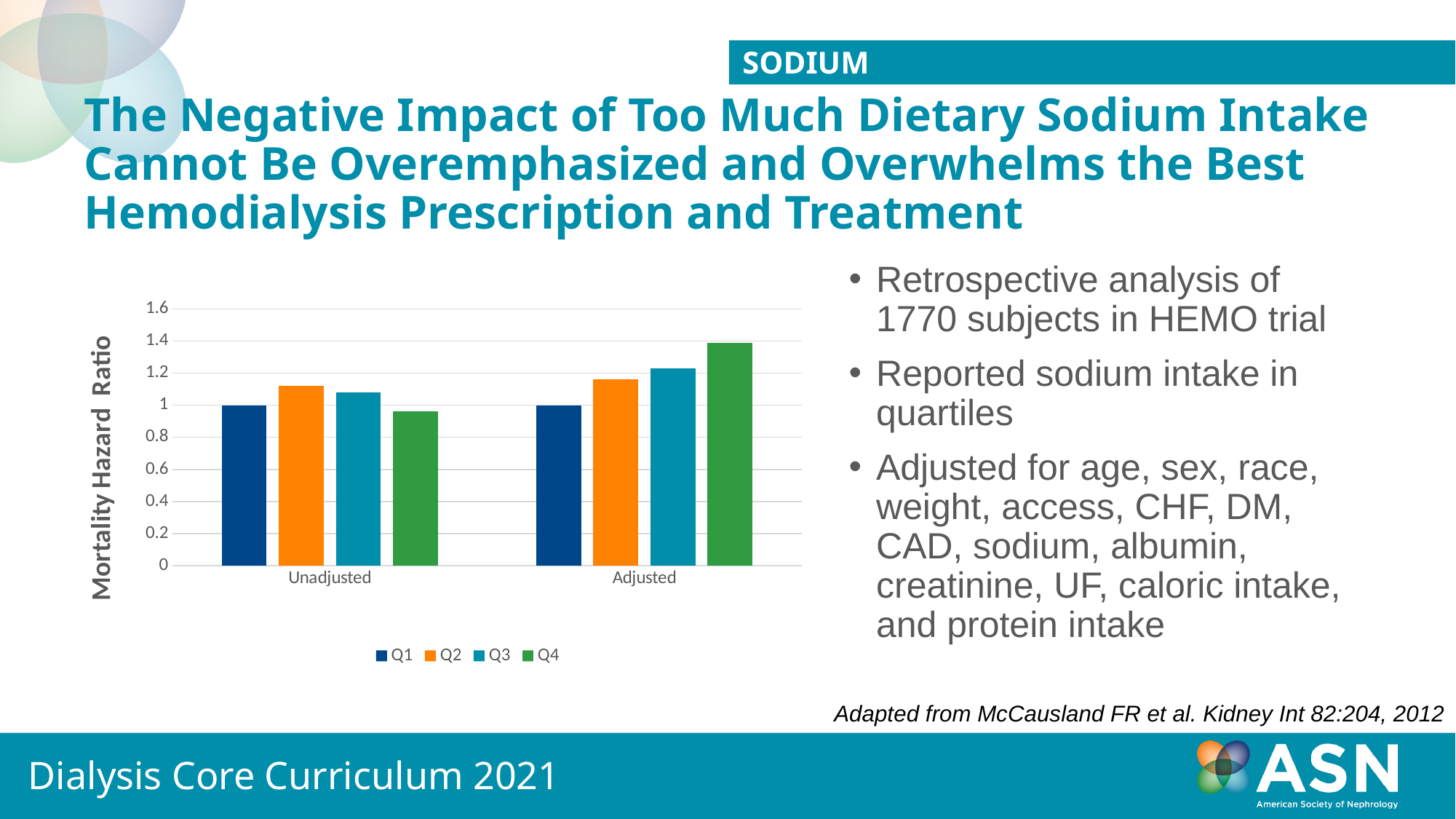
What is the Mortality Hazard Ratio for Q1 in the Adjusted group? 1 Is the Adjusted value for Q4 greater or less than 1.2? greater Which quartile has the lowest Mortality Hazard Ratio in the Unadjusted group? Q4 What is the Mortality Hazard Ratio for Q1 in the Unadjusted group? 1 Which quartile has the highest Mortality Hazard Ratio in the Adjusted group? Q4 What is the title of the chart's vertical axis? Mortality Hazard Ratio Which is larger, the Q4 value in the Adjusted group or the Q4 value in the Unadjusted group? Adjusted In the Adjusted group, do the values rise or fall from Q1 to Q4? rise How many categories are shown on the x axis of the chart? 2 Is the Unadjusted value for Q4 greater or less than 1? less What kind of chart is shown on the slide? bar chart How many series does the chart legend list? 4